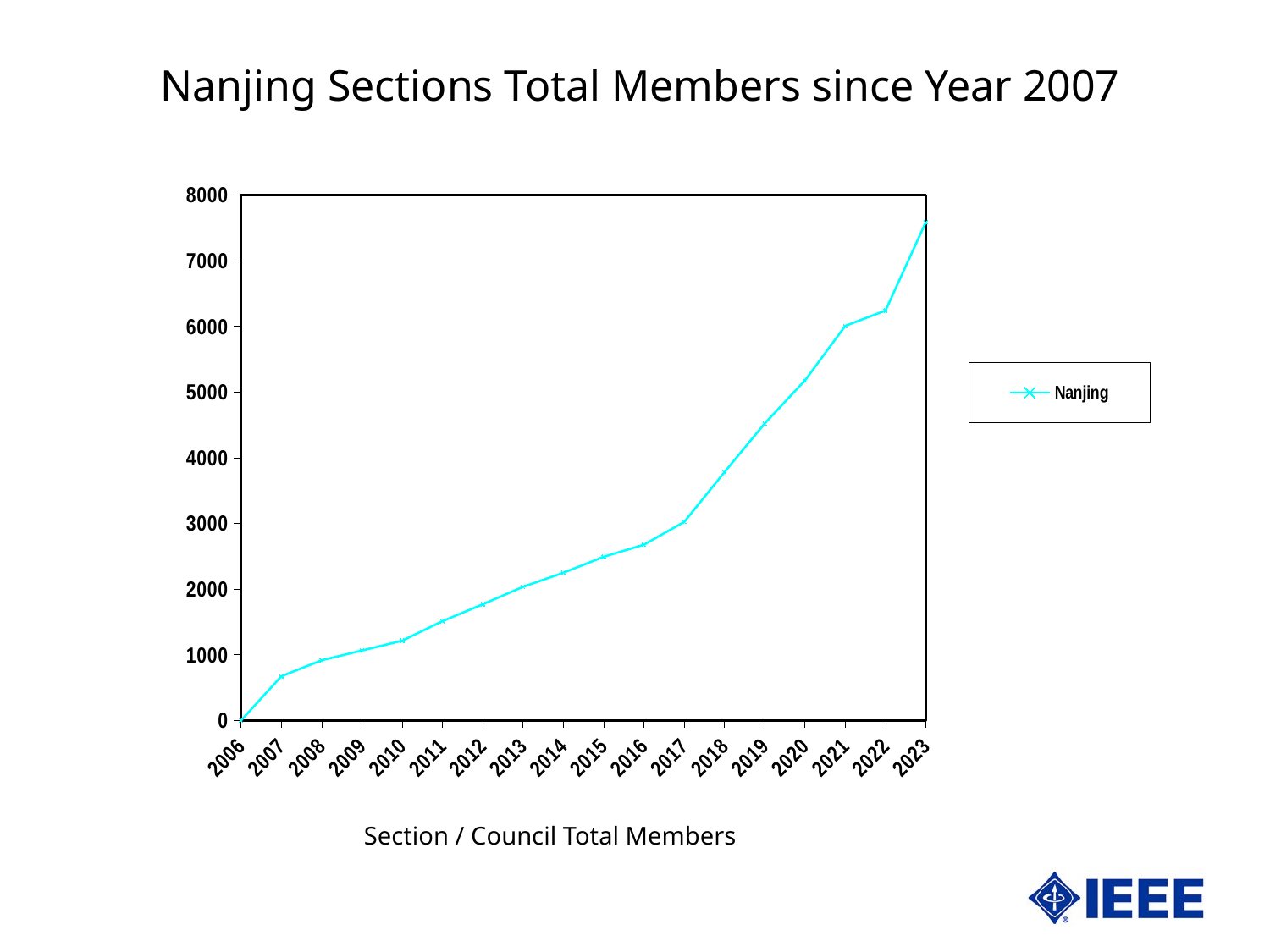
Which year has the highest number of Nanjing members? 2023 Which year has the lowest number of Nanjing members? 2006 What kind of chart is shown on the slide? line chart How many series does the legend list? 1 Is the value for Nanjing in 2016 greater or less than 3000? less How many years are plotted along the x axis? 18 What is the name of the series shown in the legend? Nanjing Is the value for Nanjing in 2023 greater or less than 7000? greater What is the value for Nanjing in 2006? 0 Do the Nanjing member values rise or fall from 2006 to 2023? rise Is the value for Nanjing in 2018 greater or less than 4000? less Which year has more Nanjing members, 2017 or 2020? 2020